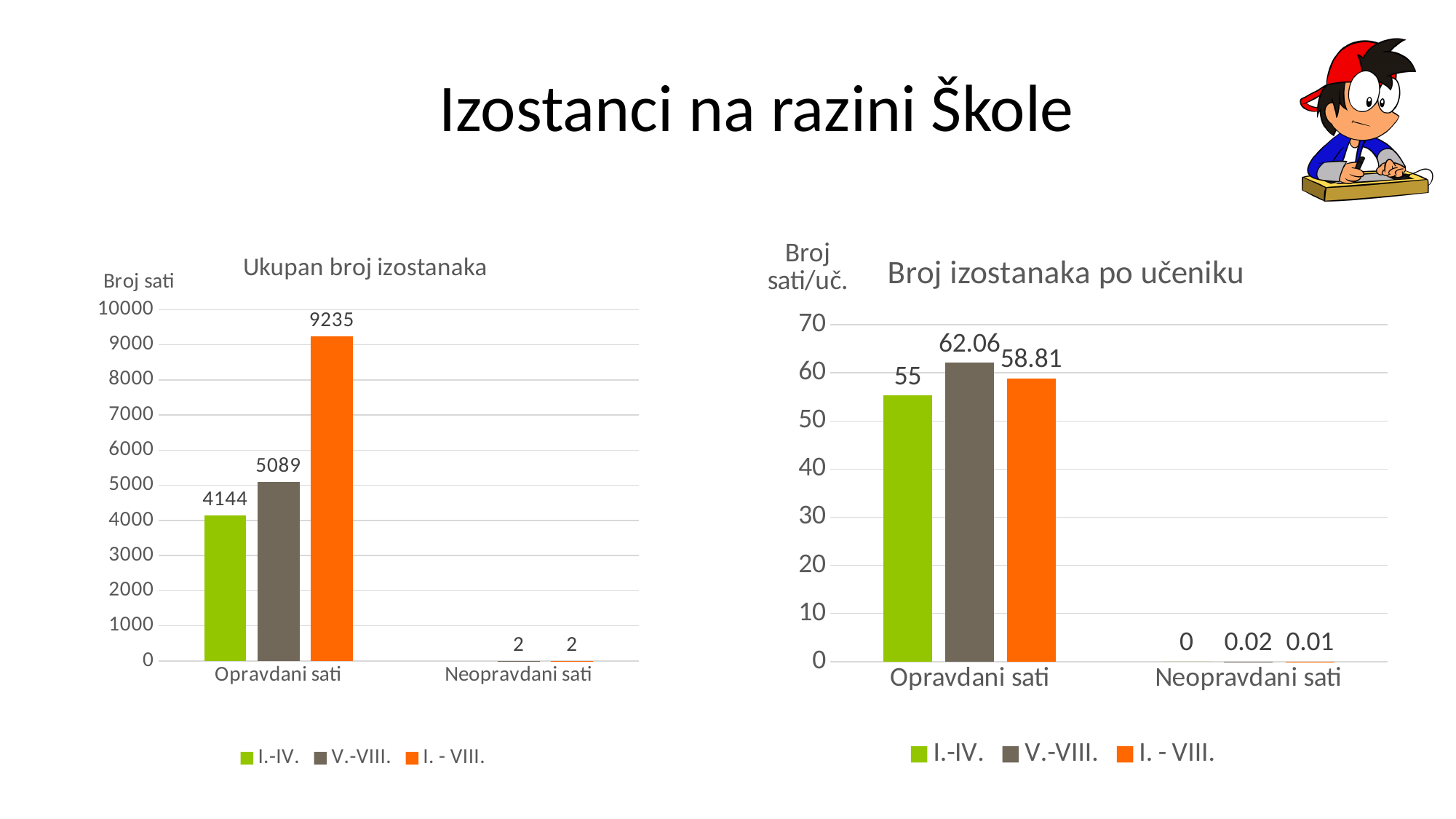
In the chart titled "Ukupan broj izostanaka", which series has the highest value for Opravdani sati? I. - VIII. In the chart titled "Broj izostanaka po učeniku", which series has the lowest value for Opravdani sati? I.-IV. In the chart titled "Broj izostanaka po učeniku", what is the value for I. - VIII. in the Neopravdani sati category? 0.01 In the chart titled "Ukupan broj izostanaka", what is the difference between the V.-VIII. and I.-IV. values for Opravdani sati? 945 In the chart titled "Broj izostanaka po učeniku", how many categories are shown on the x axis? 2 What is the y-axis label of the chart titled "Broj izostanaka po učeniku"? Broj sati/uč. What kind of chart is the chart titled "Ukupan broj izostanaka"? bar chart In the chart titled "Broj izostanaka po učeniku", what is the value for V.-VIII. in the Opravdani sati category? 62.06 In the chart titled "Broj izostanaka po učeniku", is the value for V.-VIII. in Opravdani sati larger or smaller than the value for I. - VIII.? larger In the chart titled "Ukupan broj izostanaka", what is the value for I. - VIII. in the Opravdani sati category? 9235 In the chart titled "Ukupan broj izostanaka", how many series does the legend list? 3 In the chart titled "Ukupan broj izostanaka", what is the value for I.-IV. in the Opravdani sati category? 4144